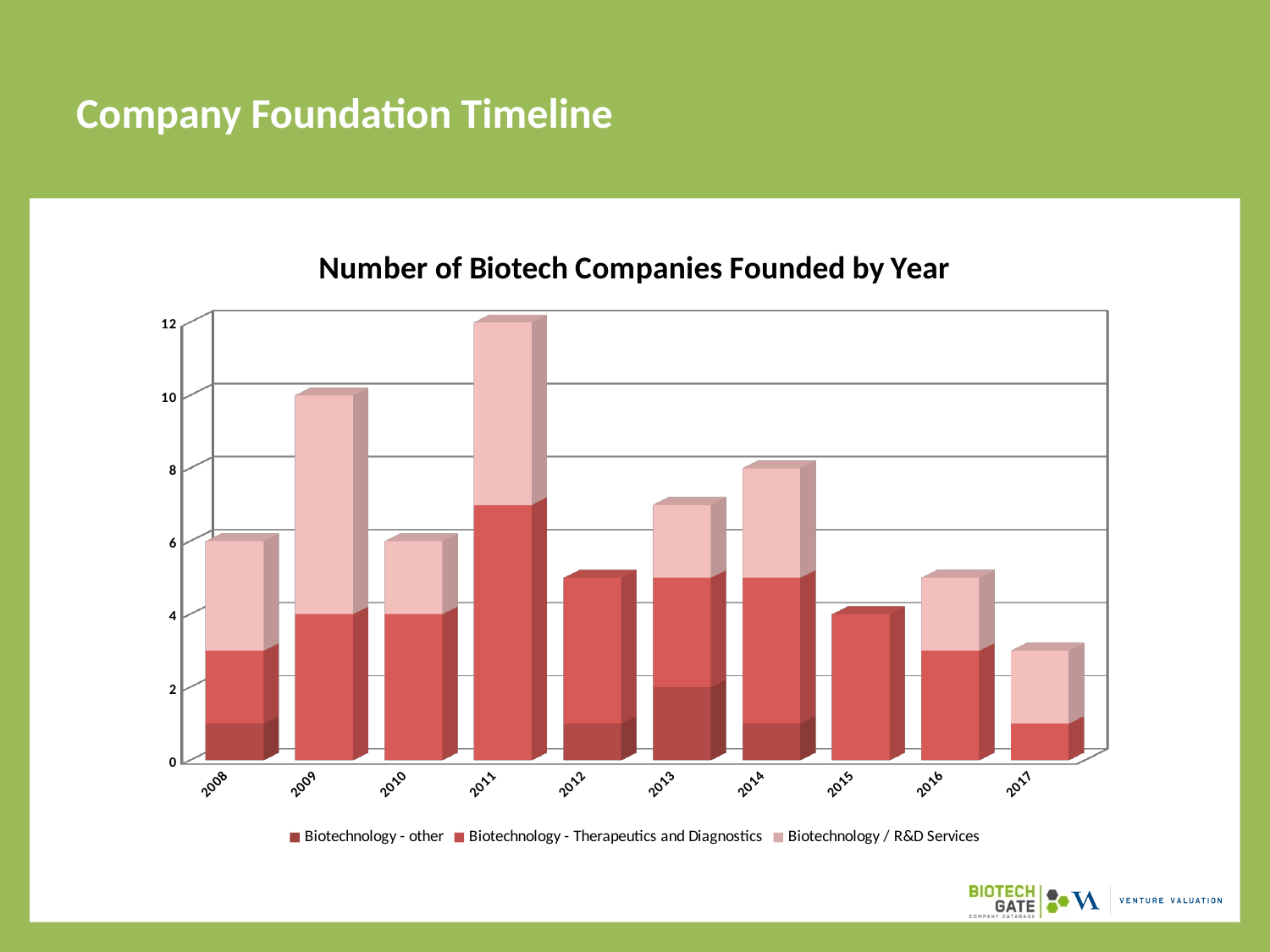
Is the total value for 2012 greater or less than 4? greater How many series does the legend list? 3 Which year has the highest total number of biotech companies founded? 2011 What is the total number of biotech companies founded in 2011? 12 Is the total value for 2017 greater or less than 4? less What is the difference between the total for 2011 and the total for 2009? 2 Which year has a larger total, 2009 or 2014? 2009 What is the total number of biotech companies founded in 2009? 10 What kind of chart is shown on the slide? Stacked bar chart Which year has the lowest total number of biotech companies founded? 2017 How many years are shown on the x axis of the chart? 10 What is the title of the chart? Number of Biotech Companies Founded by Year